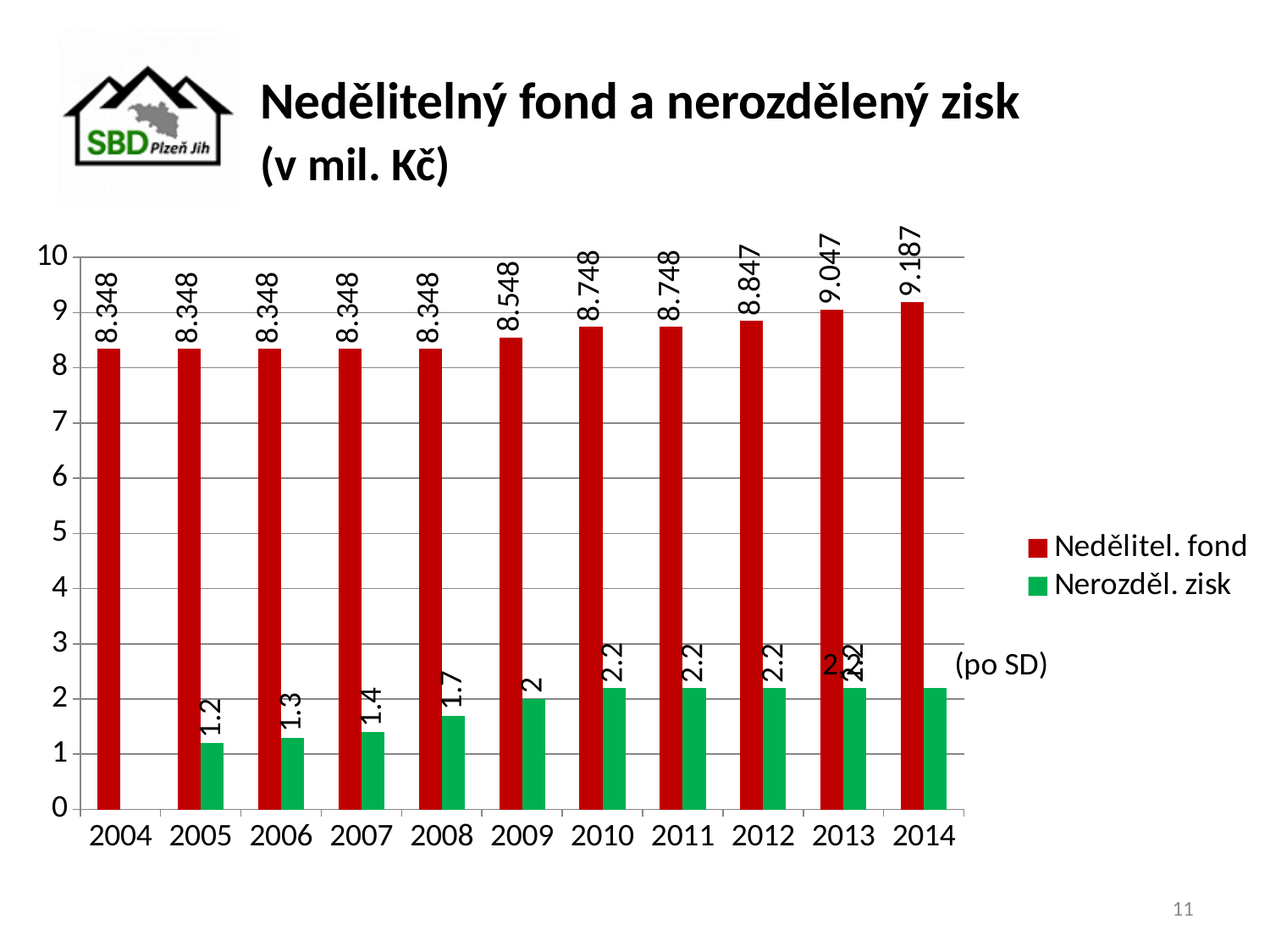
What is the difference between Nerozděl. zisk in 2009 and in 2005? 0.8 What is the value of Nerozděl. zisk in 2008? 1.7 What kind of chart is shown on the slide? bar chart What is the value of Nedělitel. fond in 2014? 9.187 How many series does the legend list? 2 Which is larger, Nedělitel. fond in 2012 or in 2013? 2013 How many years are shown on the x axis? 11 Does Nedělitel. fond rise or fall from 2004 to 2014? rises What is the difference between Nedělitel. fond in 2014 and in 2004? 0.839 Is the value of Nedělitel. fond in 2004 greater or less than 8? greater In which year is Nedělitel. fond highest? 2014 What is the value of Nedělitel. fond in 2009? 8.548